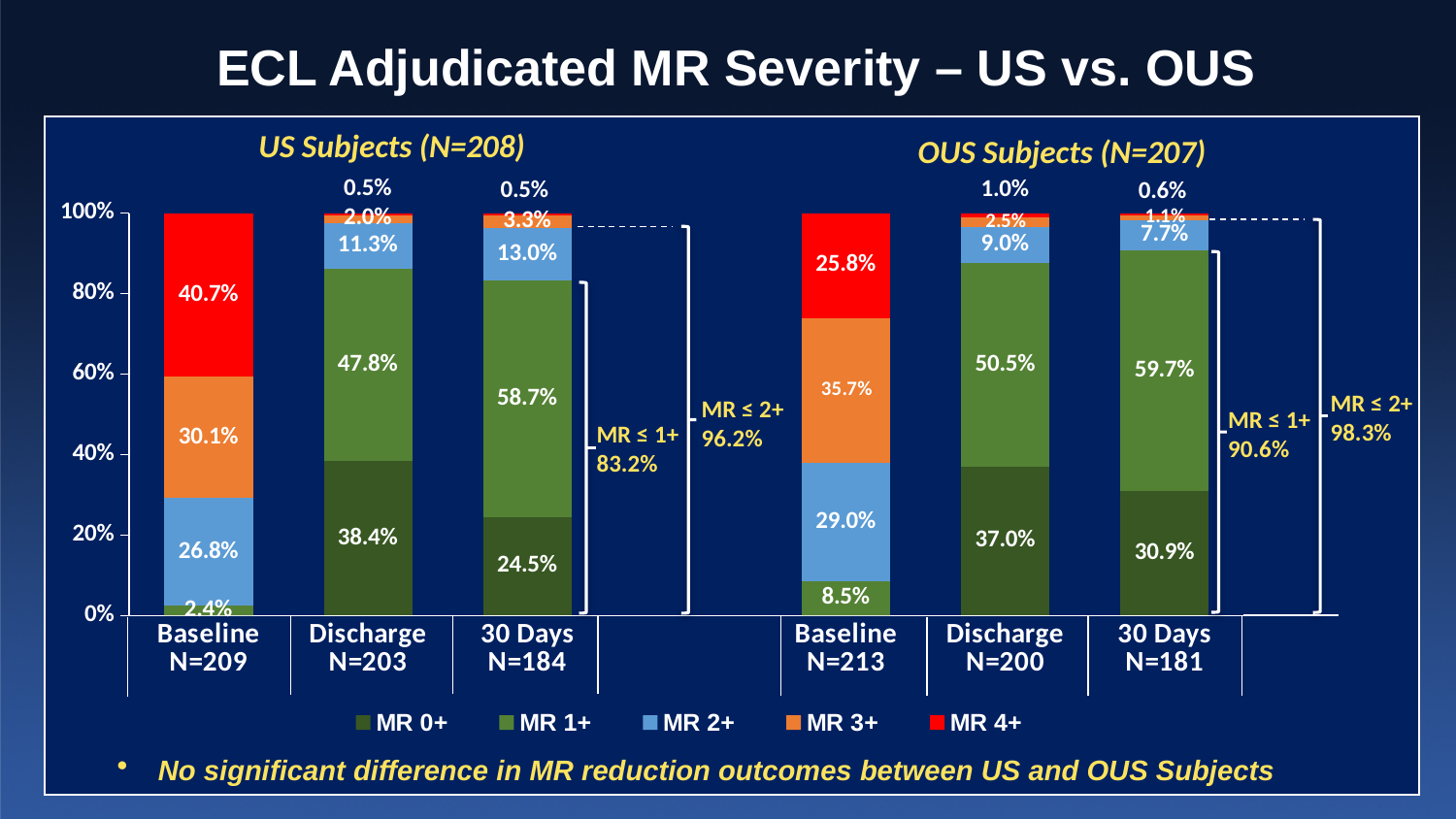
What is the MR 1+ share for OUS Subjects at 30 Days? 59.7% How many time points are shown for each subject group? 3 What kind of chart is shown on the slide? Stacked bar chart What is the MR 3+ share for OUS Subjects at Baseline? 35.7% Which is larger: the MR 1+ share at 30 Days for US Subjects or for OUS Subjects? OUS Subjects What is the difference between the MR 0+ share at Discharge and at 30 Days for US Subjects? 13.9% What is the sample size (N) for OUS Subjects at 30 Days? N=181 What is the MR 0+ share for US Subjects at Discharge? 38.4% What is the MR 4+ share for US Subjects at Baseline? 40.7% Across the three US Subjects time points, which has the highest MR 4+ share? Baseline How many series does the legend list? 5 What is the MR ≤ 2+ percentage shown for OUS Subjects at 30 Days? 98.3%